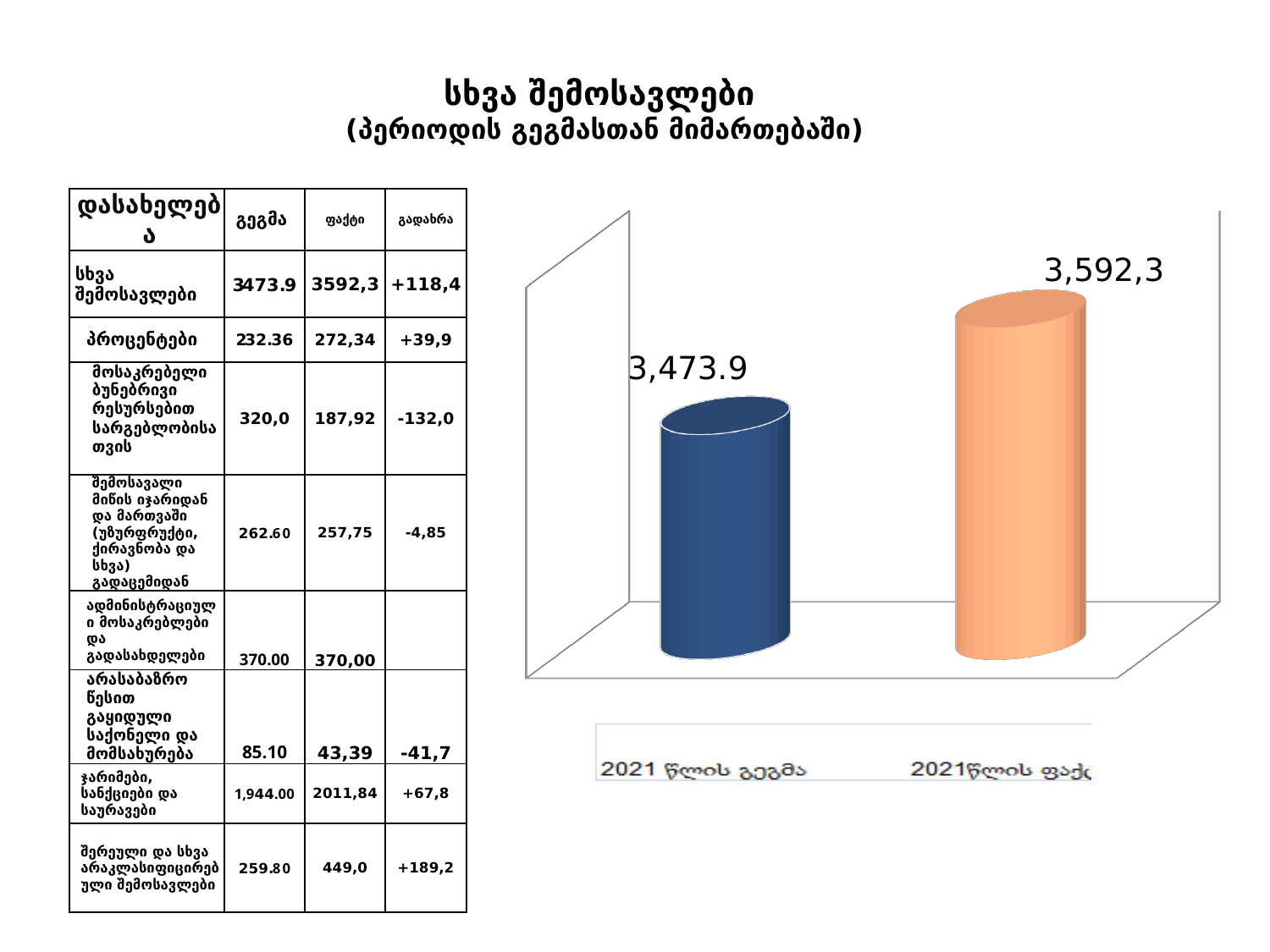
Is the value of the orange bar larger or smaller than the value of the blue bar (2021 წლის გეგმა)? larger What kind of chart is shown on the slide? Bar chart What colour is the bar for 2021 წლის გეგმა? Blue What value is shown on the orange bar (the right-hand bar) in the chart? 3,592,3 How many entries does the chart legend list? 2 What is the difference between the two bar values in the chart? 118.4 Which bar in the chart has the lower value? The blue bar (2021 წლის გეგმა) What value is shown on the blue bar labelled 2021 წლის გეგმა? 3,473.9 How many bars are plotted in the chart? 2 Which bar in the chart has the higher value? The orange bar (the right-hand bar) What is the first legend entry of the chart? 2021 წლის გეგმა